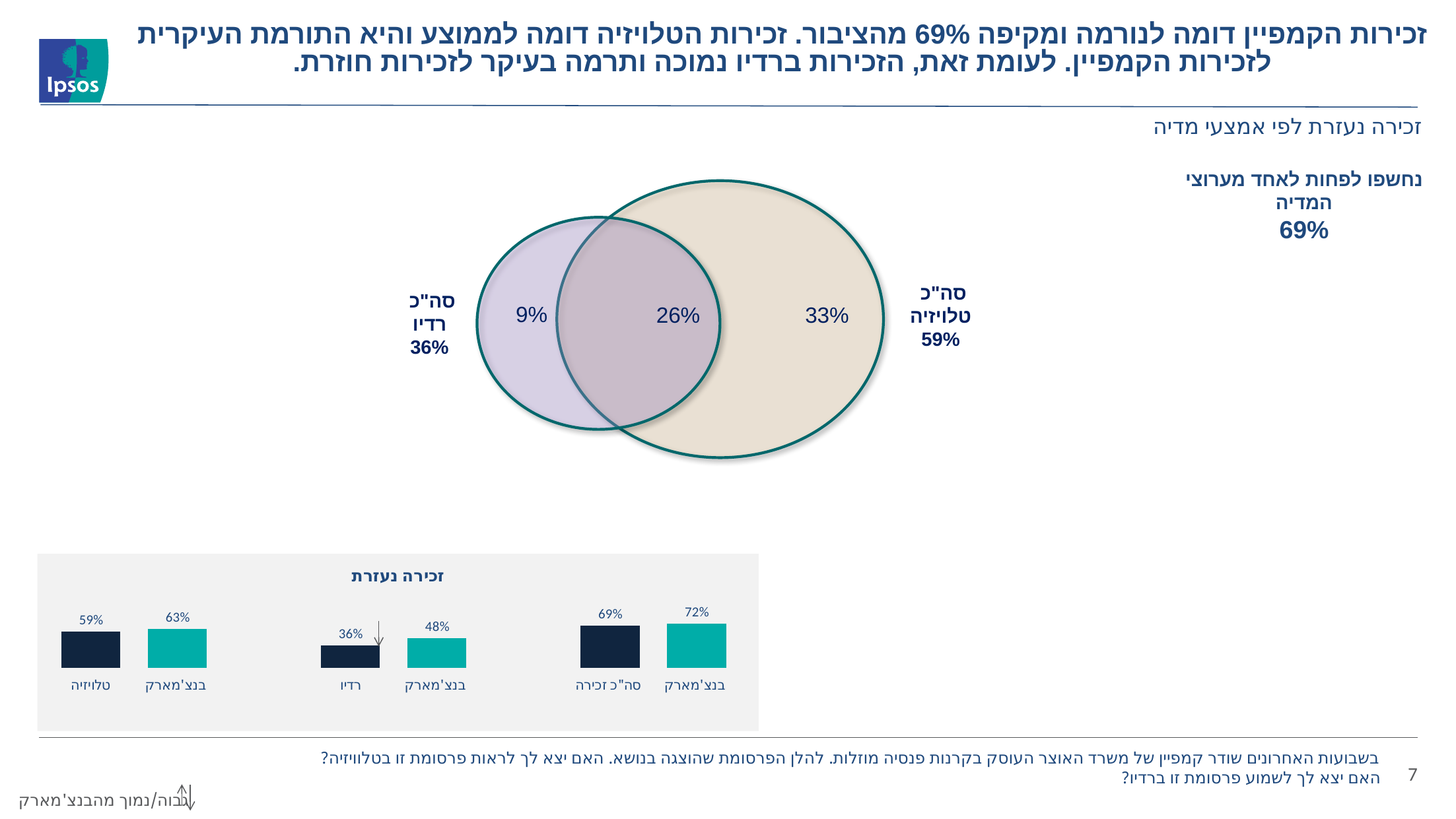
In the bar chart at the bottom of the slide, what is the difference between the בנצ'מארק value (48%) and the רדיו value (36%)? 12% In the Venn diagram, what percentage is shown in the overlap between the רדיו and טלוויזיה circles? 26% In the bar chart at the bottom of the slide, what is the בנצ'מארק value shown next to סה"כ זכירה? 72% In the bar chart at the bottom of the slide, which is larger: the value for רדיו or its בנצ'מארק value? בנצ'מארק In the Venn diagram, what is the total for סה"כ טלוויזיה? 59% In the bar chart at the bottom of the slide, what is the value for רדיו? 36% In the bar chart at the bottom of the slide, what is the value for טלוויזיה? 59% In the bar chart at the bottom of the slide, what is the בנצ'מארק value shown next to רדיו? 48% In the bar chart at the bottom of the slide, which of the three measured categories (טלוויזיה, רדיו, סה"כ זכירה) has the lowest value? רדיו What kind of chart is shown at the bottom of the slide? Bar chart In the bar chart at the bottom of the slide, what is the value for סה"כ זכירה? 69% In the bar chart at the bottom of the slide, what is the difference between the בנצ'מארק value (63%) and the טלוויזיה value (59%)? 4%